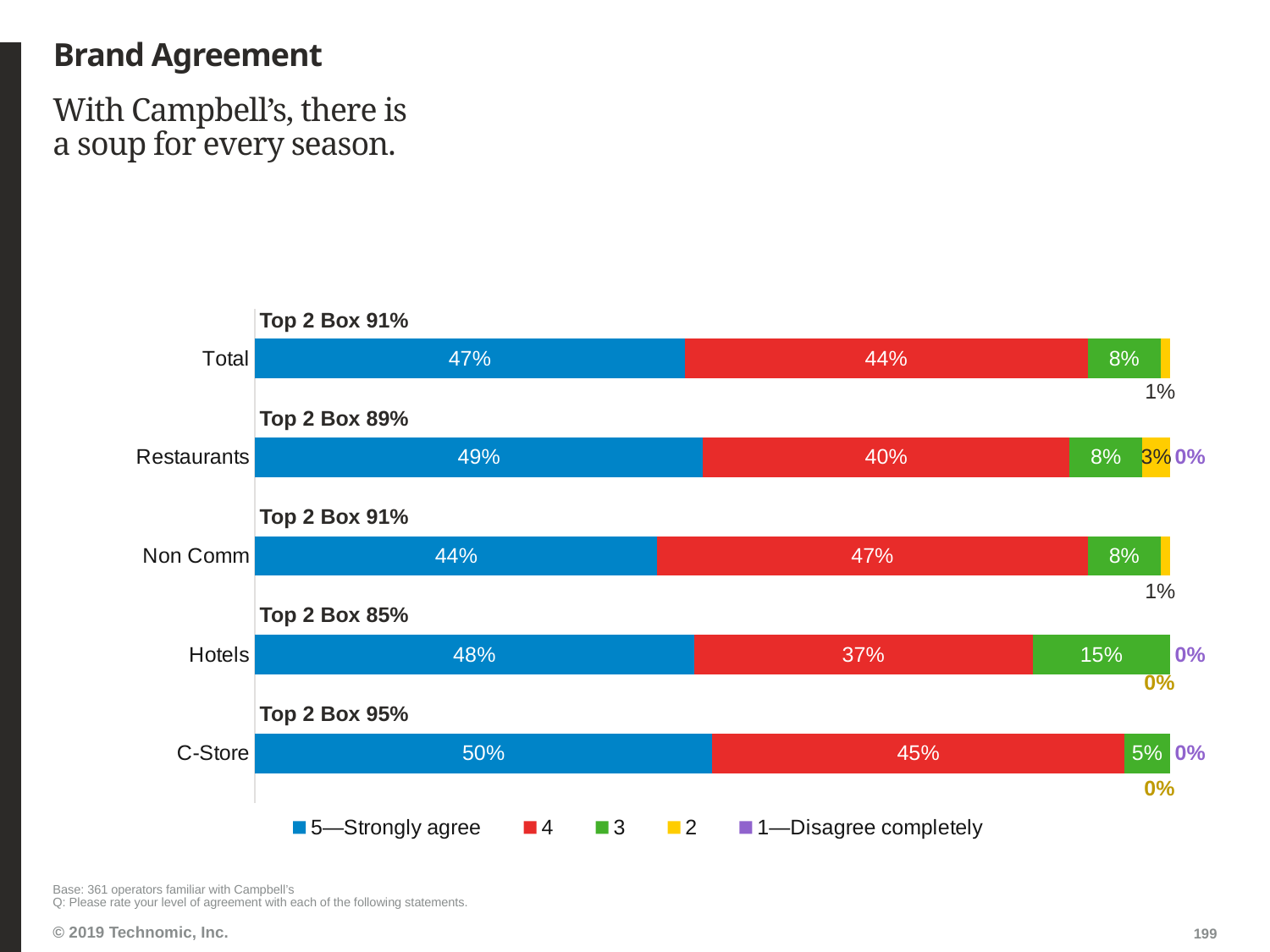
What is the Top 2 Box score shown for Hotels? 85% What percentage of Hotels respondents chose "3"? 15% What is the value for the "4" series in the Non Comm bar? 47% What is the difference between the "5—Strongly agree" and "4" values in the Total bar? 3 percentage points Which has a larger "5—Strongly agree" value, Restaurants or Non Comm? Restaurants Which category has the highest value for "5—Strongly agree"? C-Store What percentage of Total respondents chose "5—Strongly agree"? 47% Which category has the lowest value for the "4" series? Hotels How many series does the legend list? 5 How many categories are shown on the chart? 5 What kind of chart is shown on the slide? Stacked bar chart What is the value for the "4" series in the Restaurants bar? 40%